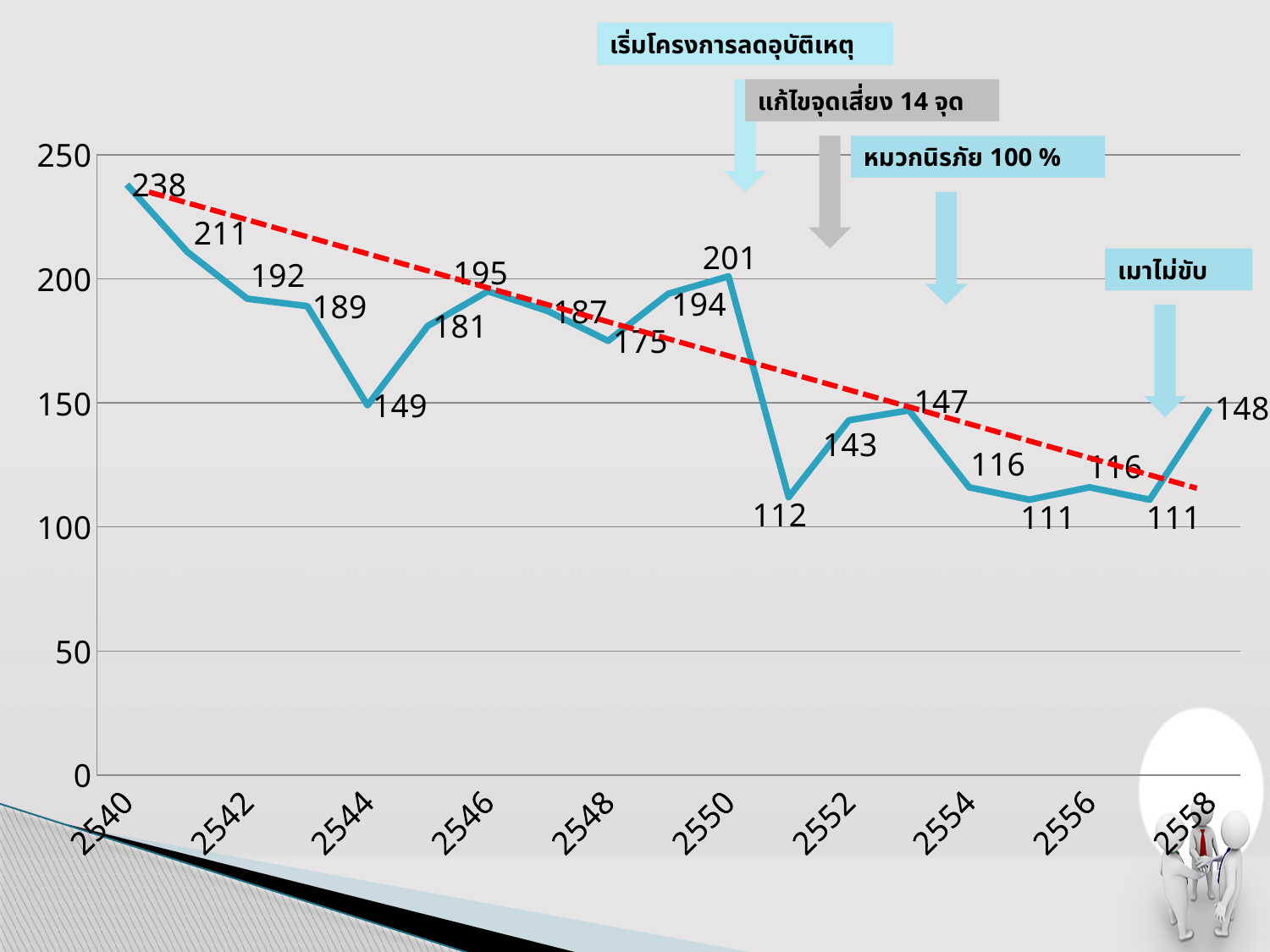
What is the value for 2550? 201 Which year has the highest value? 2540 Do the values generally rise or fall from 2540 to 2558? fall What is the value for 2558? 148 Which is larger, the value for 2550 or the value for 2552? 2550 What is the value for 2544? 149 Is the value for 2548 greater or less than 150? greater What is the lowest value plotted on the chart? 111 What is the value for 2540? 238 What is the difference between the values for 2540 and 2558? 90 What does the red dashed line on the chart represent? a trend line What kind of chart is shown on the slide? line chart